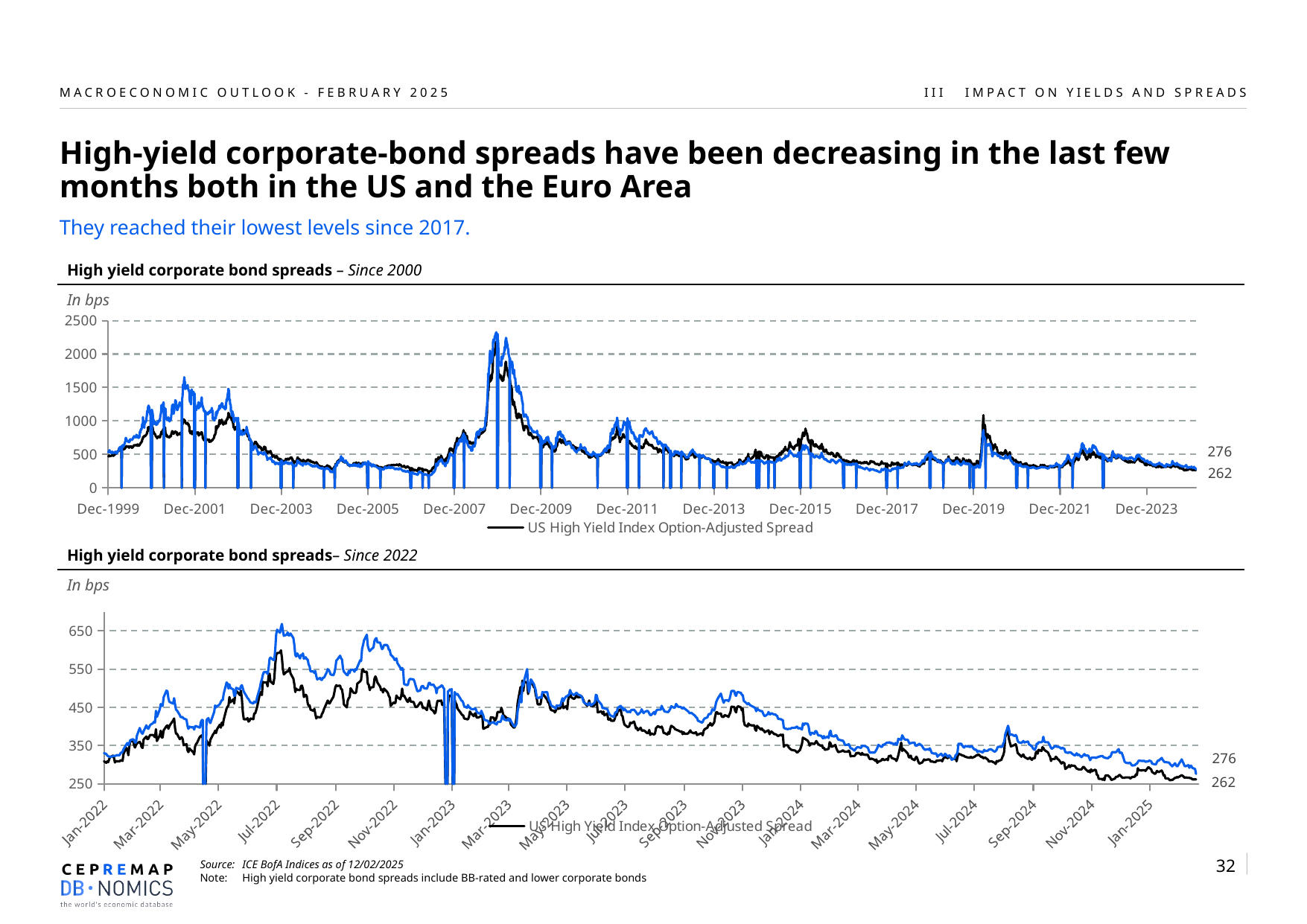
In the bottom chart (Since 2022), what is the difference between the two end-of-series labels, 276 and 262? 14 In the bottom chart (Since 2022), do the spreads rise or fall between Jan-2024 and Jan-2025? fall What kind of chart is the top chart titled 'High yield corporate bond spreads – Since 2000'? line chart In the bottom chart (Since 2022), what is the latest value labelled for the blue line? 276 How many x-axis date labels are shown on the top chart (Since 2000)? 13 In the bottom chart (Since 2022), is the peak of the US High Yield Index Option-Adjusted Spread around Jul-2022 greater or less than 550? greater In the top chart (Since 2000), what is the latest value shown for the US High Yield Index Option-Adjusted Spread (black line)? 262 In the top chart (Since 2000), is the peak of the US High Yield Index Option-Adjusted Spread between Dec-2007 and Dec-2009 greater or less than 2000? greater What series name does the legend of the top chart list? US High Yield Index Option-Adjusted Spread What unit is used on the y-axis of both charts? bps In the top chart (Since 2000), in which period does the spread reach its highest level? between Dec-2007 and Dec-2009 In the top chart (Since 2000), which end-of-series value is larger, the blue line's or the black line's? the blue line's (276)